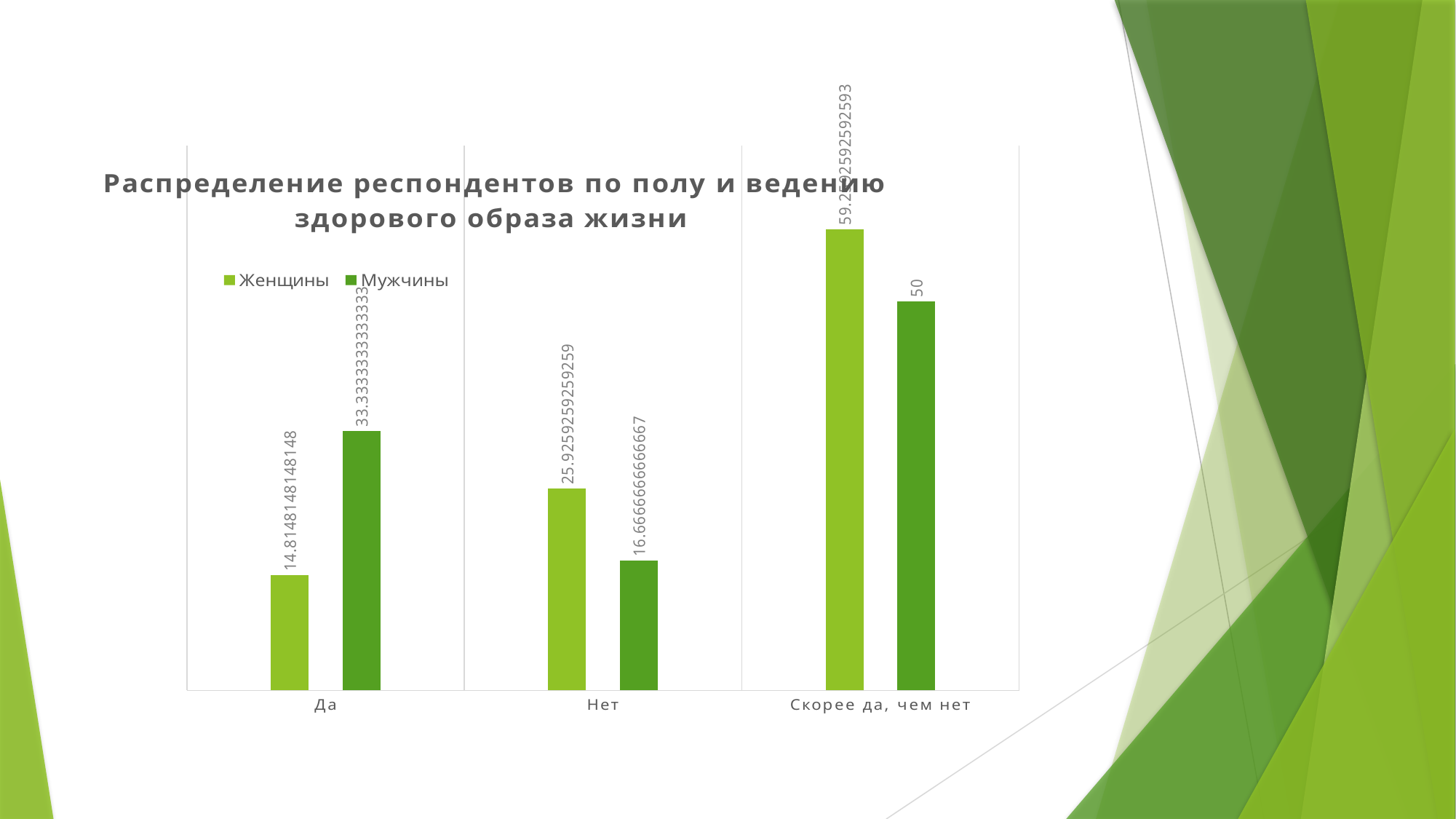
What is the value for Женщины in the category Да? 14.8148148148148 How many categories are shown on the x axis? 3 What kind of chart is shown on the slide? Bar chart How many series does the legend list? 2 What are the two entries listed in the chart legend? Женщины and Мужчины In which category is the value for Женщины the highest? Скорее да, чем нет In which category is the value for Женщины the lowest? Да In the category Да, which series has the larger value, Женщины or Мужчины? Мужчины What is the value for Женщины in the category Нет? 25.9259259259259 What is the value for Мужчины in the category Нет? 16.6666666666667 What is the value for Мужчины in the category Скорее да, чем нет? 50 In the category Нет, which series has the larger value, Женщины or Мужчины? Женщины